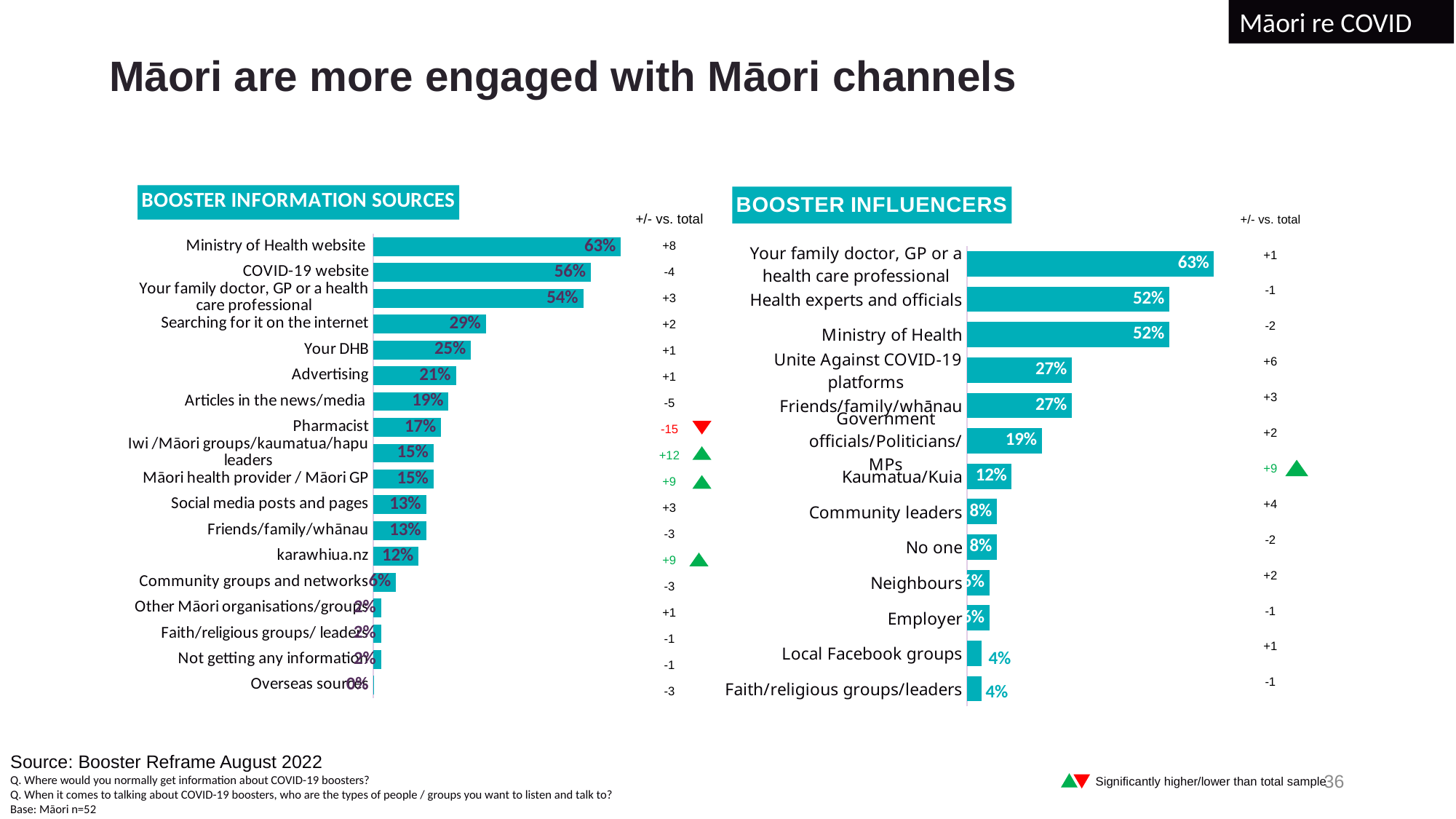
What type of chart is the BOOSTER INFORMATION SOURCES chart? Bar chart How many categories are plotted in the BOOSTER INFLUENCERS chart? 13 In the BOOSTER INFORMATION SOURCES chart, what is the value for Your DHB? 25% In the BOOSTER INFORMATION SOURCES chart, what is the +/- vs. total figure shown for Pharmacist? -15 In the BOOSTER INFORMATION SOURCES chart, which category has the lowest value? Overseas sources In the BOOSTER INFLUENCERS chart, which is larger: Health experts and officials or Community leaders? Health experts and officials In the BOOSTER INFLUENCERS chart, which category has the highest value? Your family doctor, GP or a health care professional In the BOOSTER INFORMATION SOURCES chart, what is the value for karawhiua.nz? 12% In the BOOSTER INFORMATION SOURCES chart, what is the difference between the COVID-19 website value and the Pharmacist value? 39% In the BOOSTER INFORMATION SOURCES chart, what percentage is shown for Ministry of Health website? 63% In the BOOSTER INFLUENCERS chart, what is the value for Kaumatua/Kuia? 12% In the BOOSTER INFLUENCERS chart, what percentage is shown for Unite Against COVID-19 platforms? 27%